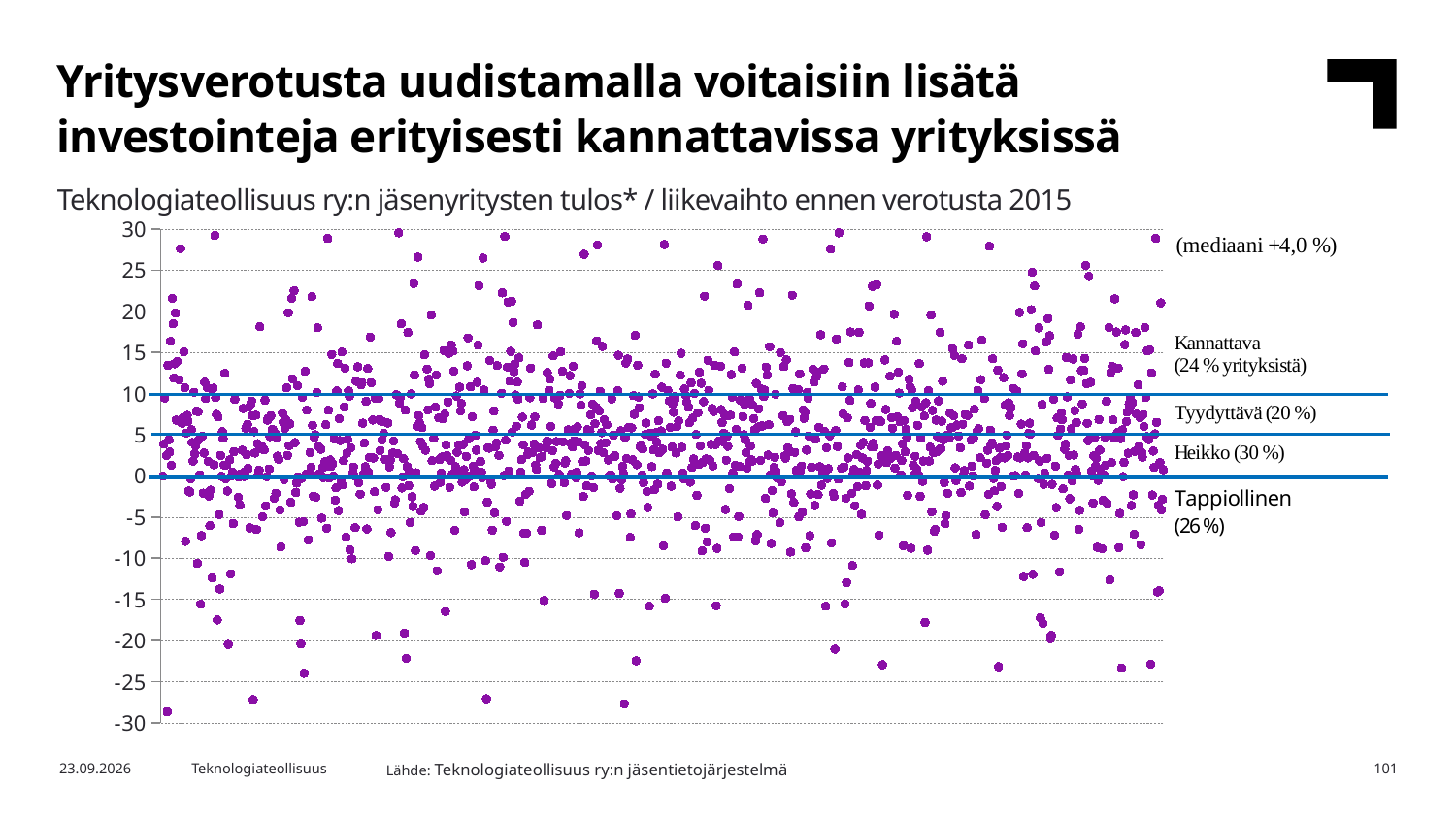
What share of companies is labelled as Tappiollinen on the chart? 26 % What is the title of the chart? Teknologiateollisuus ry:n jäsenyritysten tulos* / liikevaihto ennen verotusta 2015 What share of companies is labelled as Tyydyttävä on the chart? 20 % What are the highest and lowest values shown on the vertical axis? 30 and -30 What share of companies is labelled as Heikko on the chart? 30 % Which category has the smallest share of companies: Kannattava, Tyydyttävä, Heikko or Tappiollinen? Tyydyttävä Is the share of Tappiollinen companies larger or smaller than the share of Kannattava companies? Larger What median value is stated on the chart? +4,0 % What share of companies is labelled as Kannattava on the chart? 24 % Which category has the largest share of companies: Kannattava, Tyydyttävä, Heikko or Tappiollinen? Heikko What kind of chart is shown on the slide? Scatter plot What is the difference between the share of Heikko companies and the share of Tyydyttävä companies? 10 percentage points